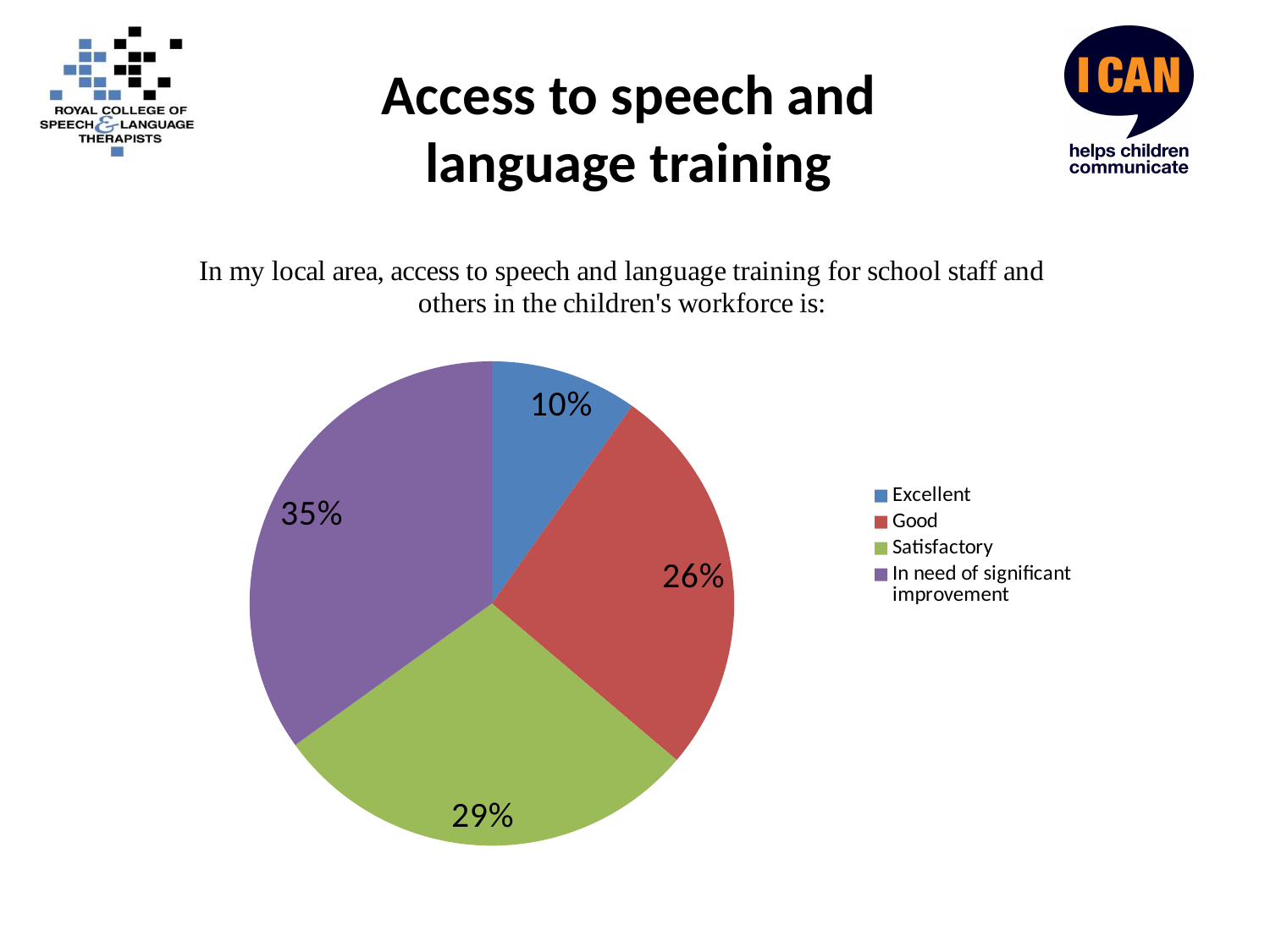
What colour is the slice for In need of significant improvement? Purple What percentage of respondents rated access to speech and language training as Excellent? 10% What percentage of respondents said access is In need of significant improvement? 35% What type of chart is shown on the slide? Pie chart Which category has the smallest share of the pie? Excellent How many categories does the pie chart show? 4 What is the difference in percentage points between the In need of significant improvement and Excellent slices? 25 What percentage of respondents rated access as Satisfactory? 29% Which category has the largest share of the pie? In need of significant improvement Which is larger, the Good slice or the Satisfactory slice? Satisfactory What percentage of respondents rated access as Good? 26% What is the difference in percentage points between the Satisfactory and Good slices? 3